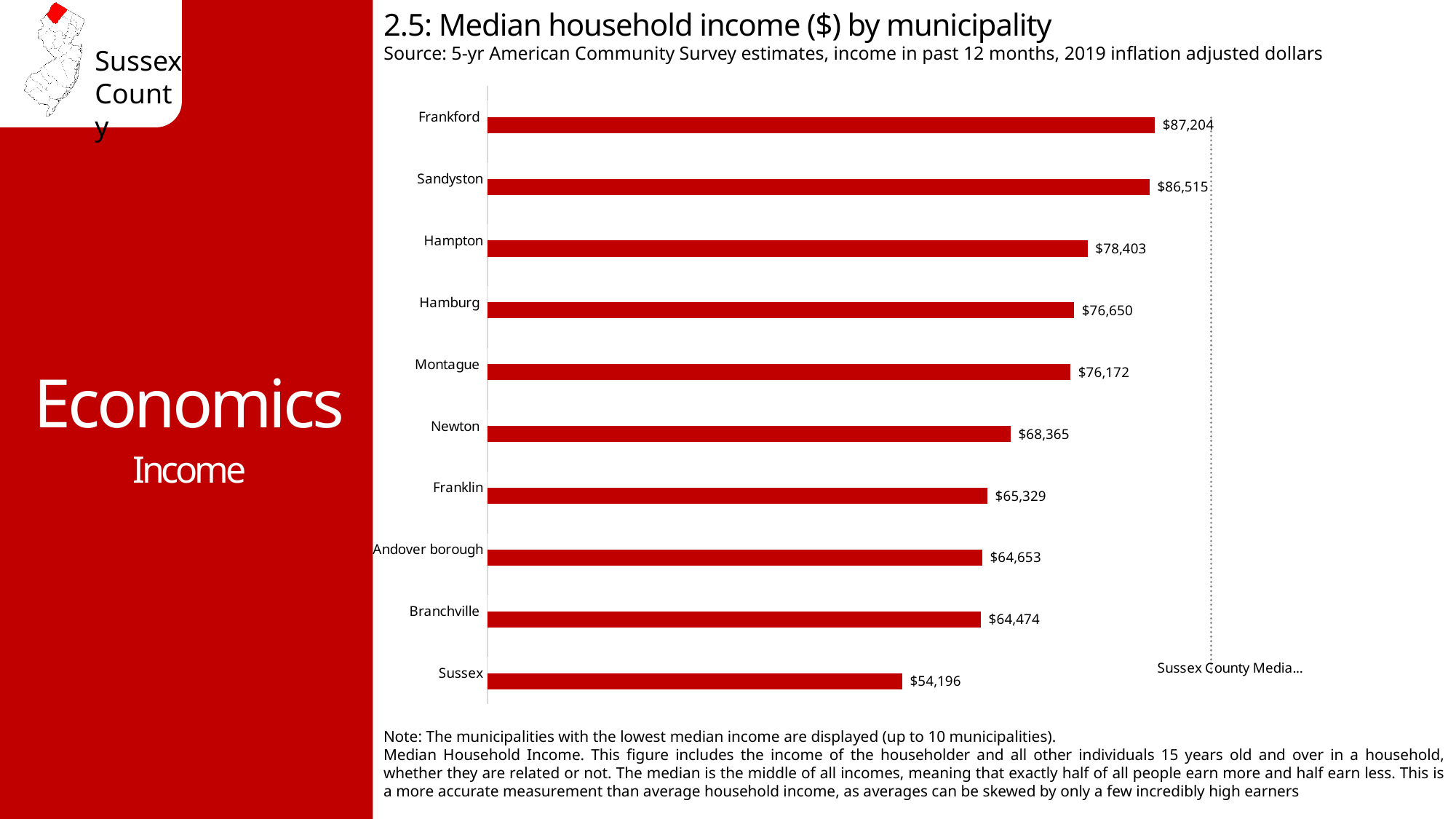
Which municipality has the highest median household income on the chart? Frankford Which has a higher median household income, Sussex or Branchville? Branchville What is the median household income for Andover borough? $64,653 What is the difference between the median household income of Hampton and Hamburg? $1,753 Which municipality has the lowest median household income on the chart? Sussex What is the median household income for Newton? $68,365 How many municipalities are shown on the chart? 10 What is the difference between the median household income of Frankford and Sussex? $33,008 What does the dotted vertical line on the chart represent? Sussex County Median Which has a higher median household income, Newton or Franklin? Newton What kind of chart is used to show median household income by municipality? Bar chart What is the median household income for Frankford? $87,204